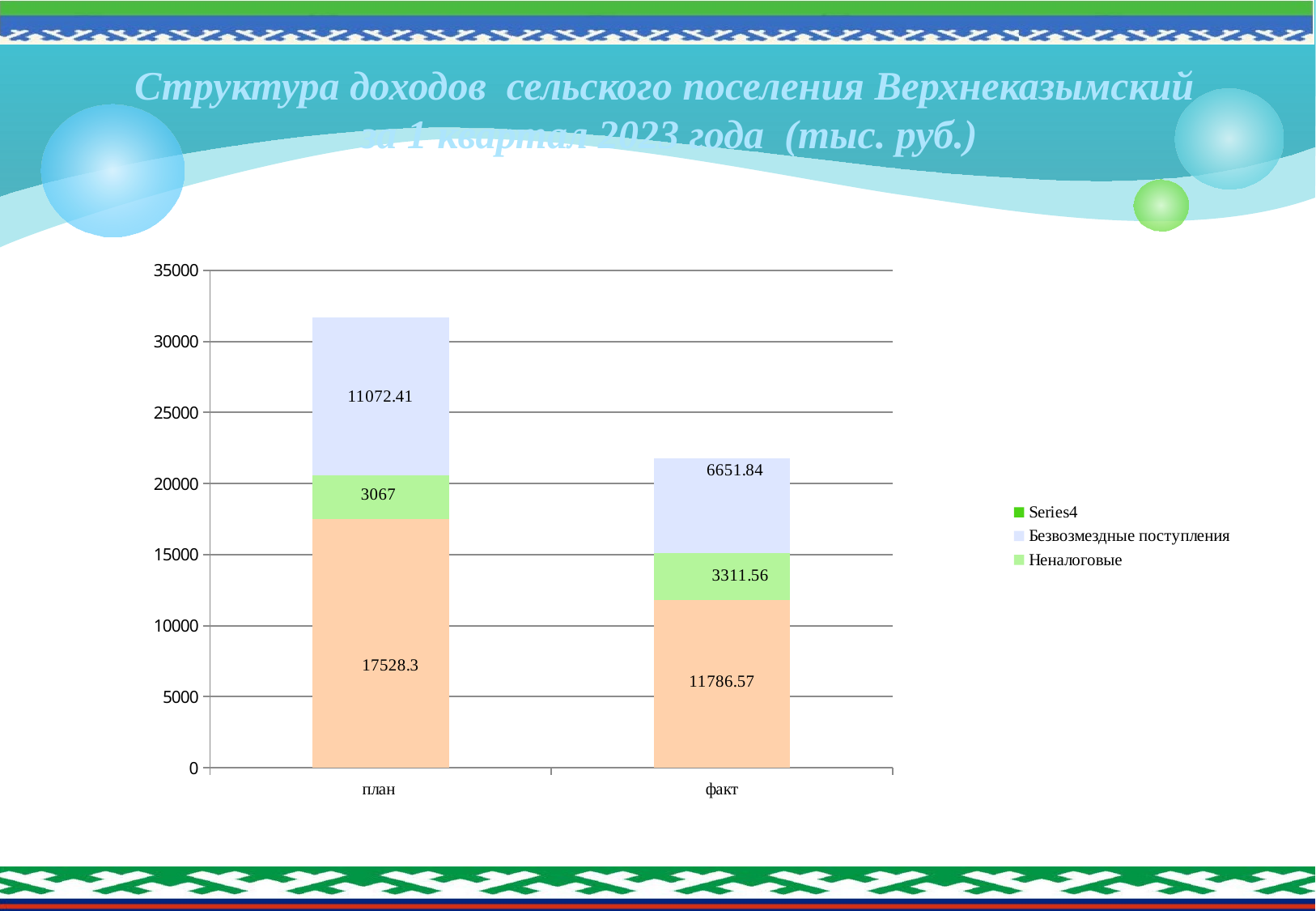
What is the value of the bottom (orange) segment of the факт bar? 11786.57 What type of chart is shown on the slide? stacked bar chart What is the difference between Безвозмездные поступления for план and for факт? 4420.57 What is the total of the stacked bar for факт? 21749.97 How many categories are shown on the x axis of the chart? 2 What is the value of Безвозмездные поступления for факт? 6651.84 Which is larger, Неналоговые for план or Неналоговые for факт? факт What is the value of Неналоговые for факт? 3311.56 How many series does the chart legend list? 3 What is the total of the stacked bar for план? 31667.71 What is the value of Неналоговые for план? 3067 What is the value of Безвозмездные поступления for план? 11072.41